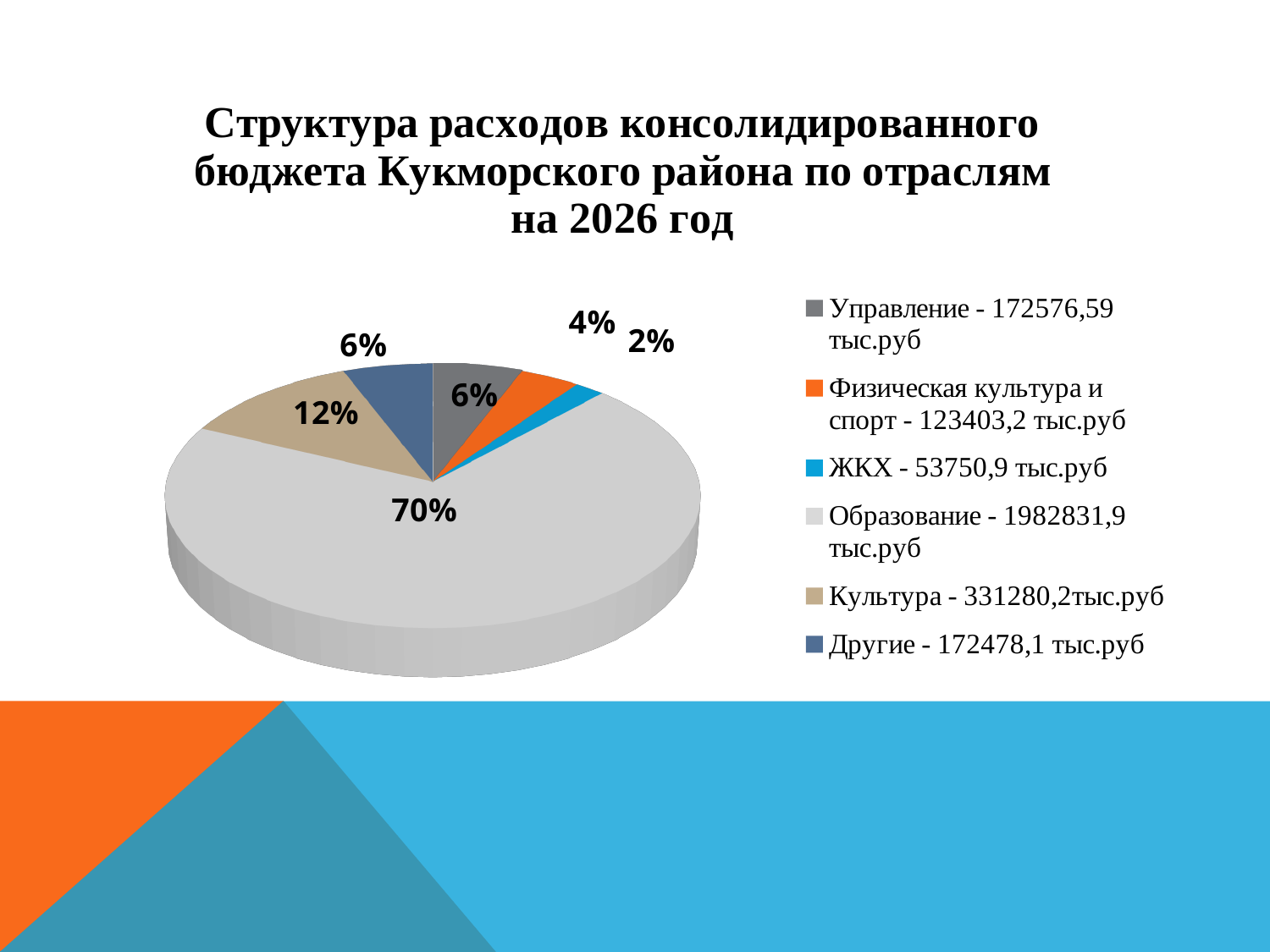
What share of the pie does Культура take? 12% Which category has the smallest share of the pie? ЖКХ How many slices does the pie chart have? 6 Which is larger, the share for Культура or the share for Управление? Культура What kind of chart is shown on the slide? Pie chart How many entries does the legend list? 6 What value is given for Физическая культура и спорт in the legend? 123403,2 тыс.руб What share of the pie does Образование take? 70% What is the difference in percentage points between the Образование share and the Культура share? 58 Which category has the largest share of the pie? Образование What value is given for Другие in the legend? 172478,1 тыс.руб What share of the pie does ЖКХ take? 2%